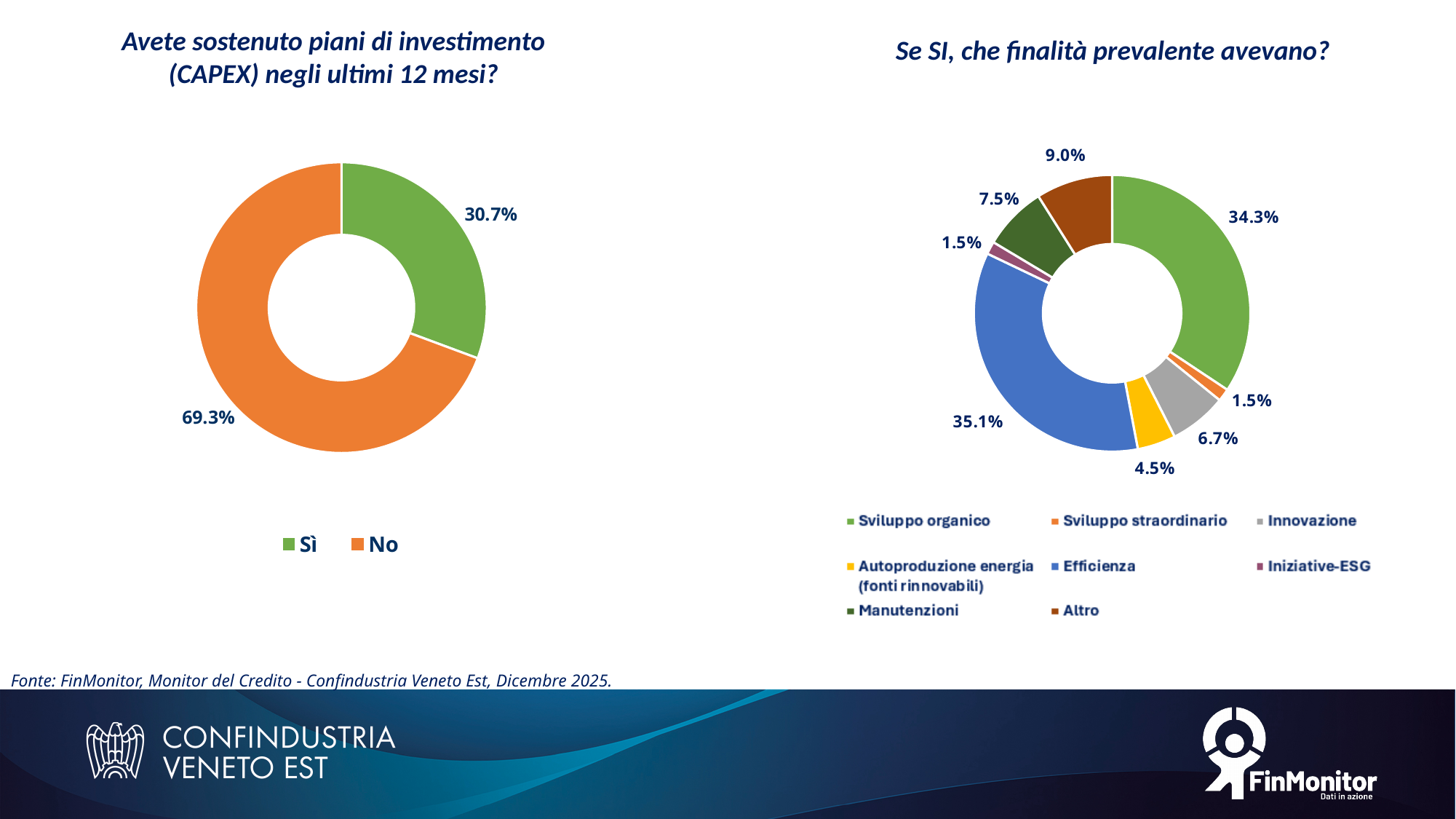
In the right chart (Se SI, che finalità prevalente avevano?), what is the share for Innovazione? 6.7% In the left chart (CAPEX in the last 12 months), what is the difference in percentage points between No and Sì? 38.6 In the left chart (CAPEX in the last 12 months), which answer has the larger share, Sì or No? No In the left chart (CAPEX in the last 12 months), what percentage answered No? 69.3% In the right chart (Se SI, che finalità prevalente avevano?), which category has the largest share? Efficienza In the right chart (Se SI, che finalità prevalente avevano?), which is larger, Autoproduzione energia (fonti rinnovabili) or Innovazione? Innovazione In the right chart (Se SI, che finalità prevalente avevano?), what is the share for Efficienza? 35.1% In the right chart (Se SI, che finalità prevalente avevano?), what is the difference in percentage points between Altro and Manutenzioni? 1.5 In the left chart (CAPEX in the last 12 months), what percentage answered Sì? 30.7% What type of chart is used on the left side of the slide? Donut (pie) chart In the right chart (Se SI, che finalità prevalente avevano?), what is the share for Sviluppo organico? 34.3% In the right chart (Se SI, che finalità prevalente avevano?), how many categories does the legend list? 8